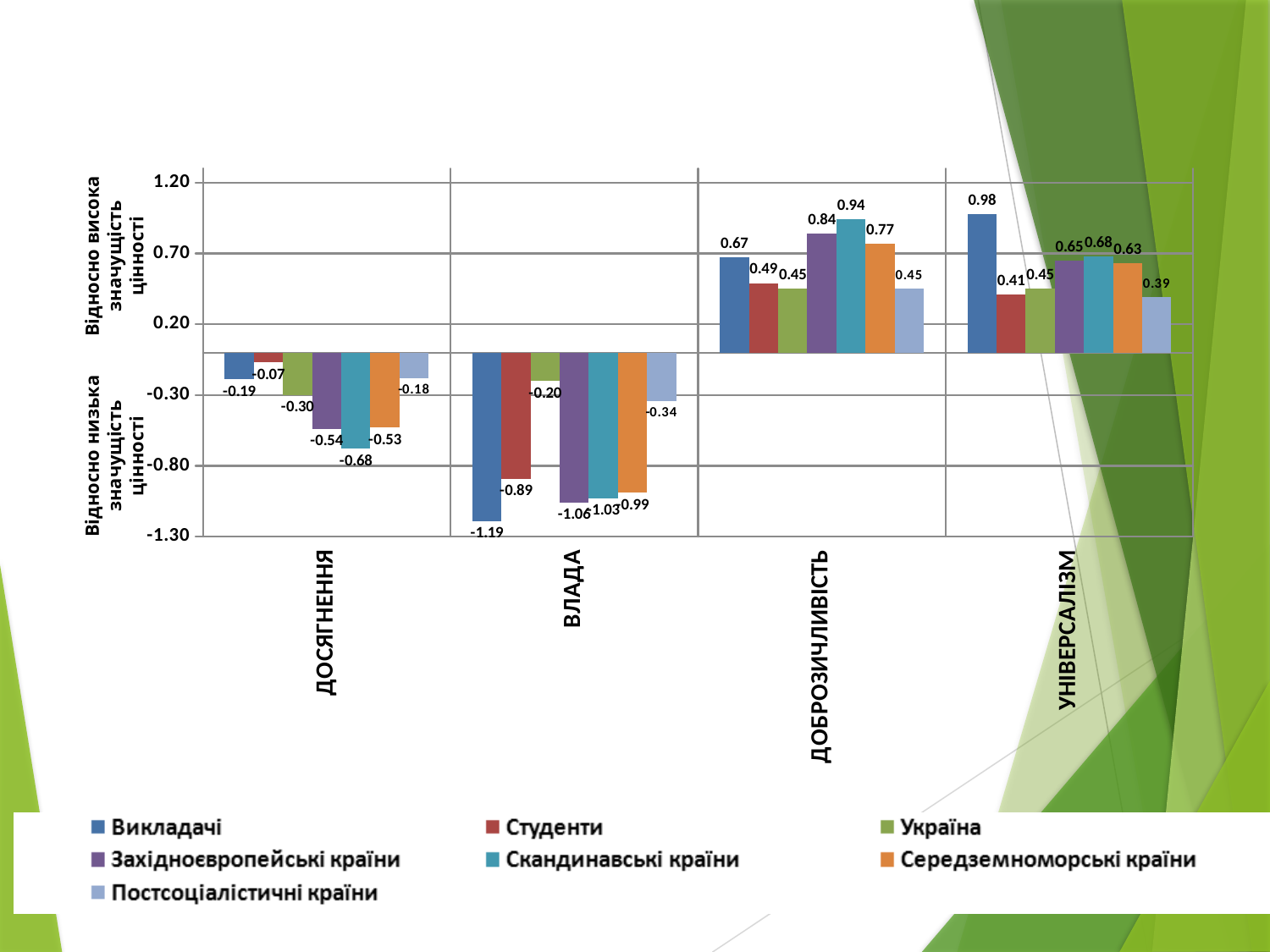
What is the value for Скандинавські країни in the ДОБРОЗИЧЛИВІСТЬ category? 0.94 Is the value for Скандинавські країни in the ДОСЯГНЕННЯ category greater or less than -0.30? less What is the value for Постсоціалістичні країни in the ВЛАДА category? -0.34 How many series does the legend list? 7 What is the difference between the Викладачі and Студенти values in the УНІВЕРСАЛІЗМ category? 0.57 Which series has the highest value in the УНІВЕРСАЛІЗМ category? Викладачі What is the value for Україна in the ДОСЯГНЕННЯ category? -0.30 In the ДОБРОЗИЧЛИВІСТЬ category, which is larger: the value for Західноєвропейські країни or the value for Середземноморські країни? Західноєвропейські країни What is the value for Викладачі in the ВЛАДА category? -1.19 What kind of chart is shown on the slide? bar chart How many categories are shown on the x axis? 4 Which series has the lowest value in the ВЛАДА category? Викладачі